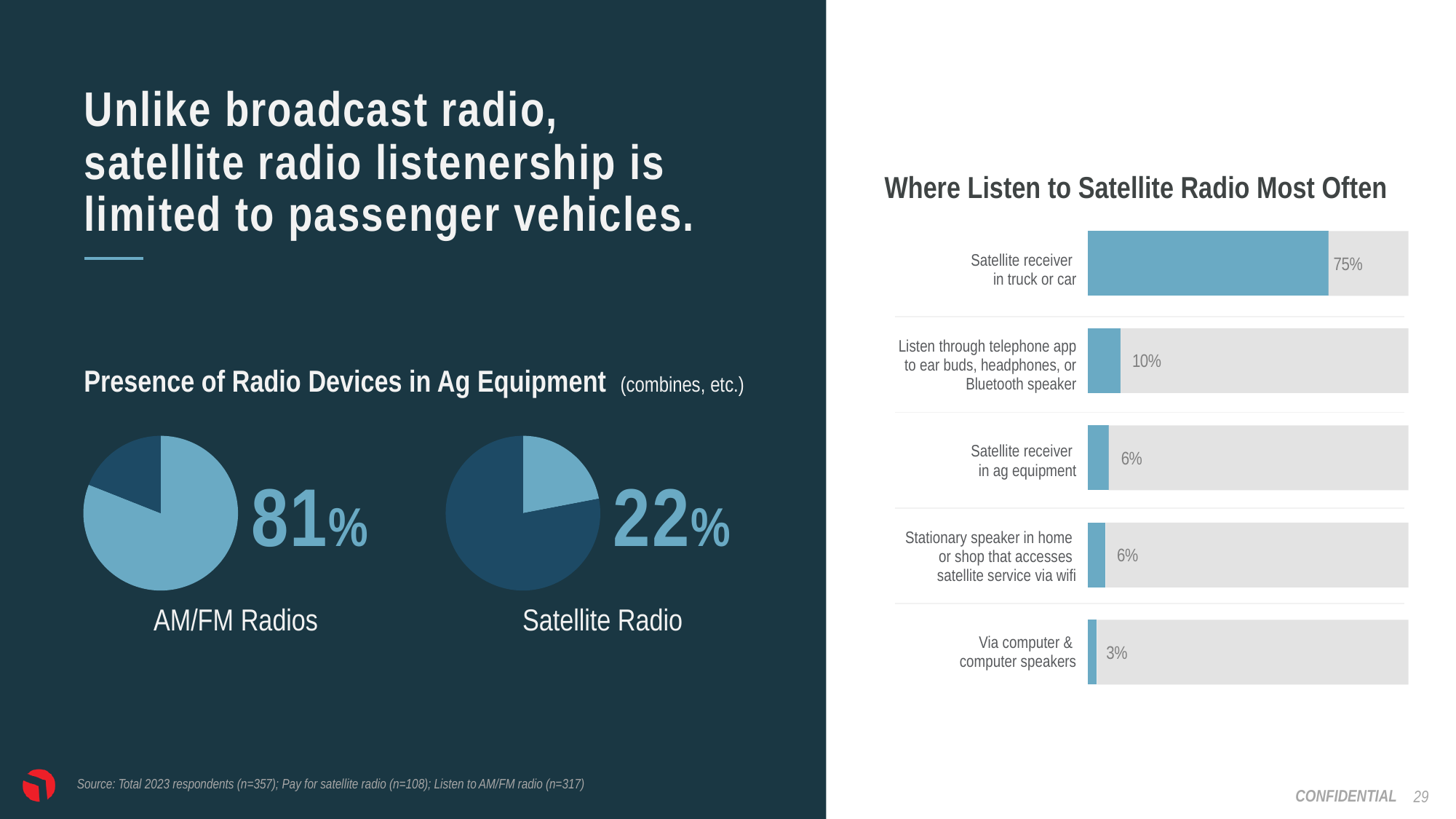
In the 'Where Listen to Satellite Radio Most Often' chart, which category has the lowest value? Via computer & computer speakers In the 'Where Listen to Satellite Radio Most Often' chart, what is the value for 'Satellite receiver in truck or car'? 75% In the 'Where Listen to Satellite Radio Most Often' chart, how many categories are shown? 5 In the 'Where Listen to Satellite Radio Most Often' chart, what is the difference between 'Satellite receiver in truck or car' and 'Satellite receiver in ag equipment'? 69% In the 'Where Listen to Satellite Radio Most Often' chart, which category has the highest value? Satellite receiver in truck or car What kind of chart is 'Where Listen to Satellite Radio Most Often'? Bar chart In the 'Presence of Radio Devices in Ag Equipment' charts, what percentage is shown for AM/FM Radios? 81% In the 'Presence of Radio Devices in Ag Equipment' charts, which is larger: the AM/FM Radios value or the Satellite Radio value? AM/FM Radios In the 'Where Listen to Satellite Radio Most Often' chart, what is the value for 'Listen through telephone app to ear buds, headphones, or Bluetooth speaker'? 10% In the 'Presence of Radio Devices in Ag Equipment' charts, what percentage is shown for Satellite Radio? 22% What kind of charts are used for 'Presence of Radio Devices in Ag Equipment'? Pie charts In the 'Where Listen to Satellite Radio Most Often' chart, what is the value for 'Via computer & computer speakers'? 3%